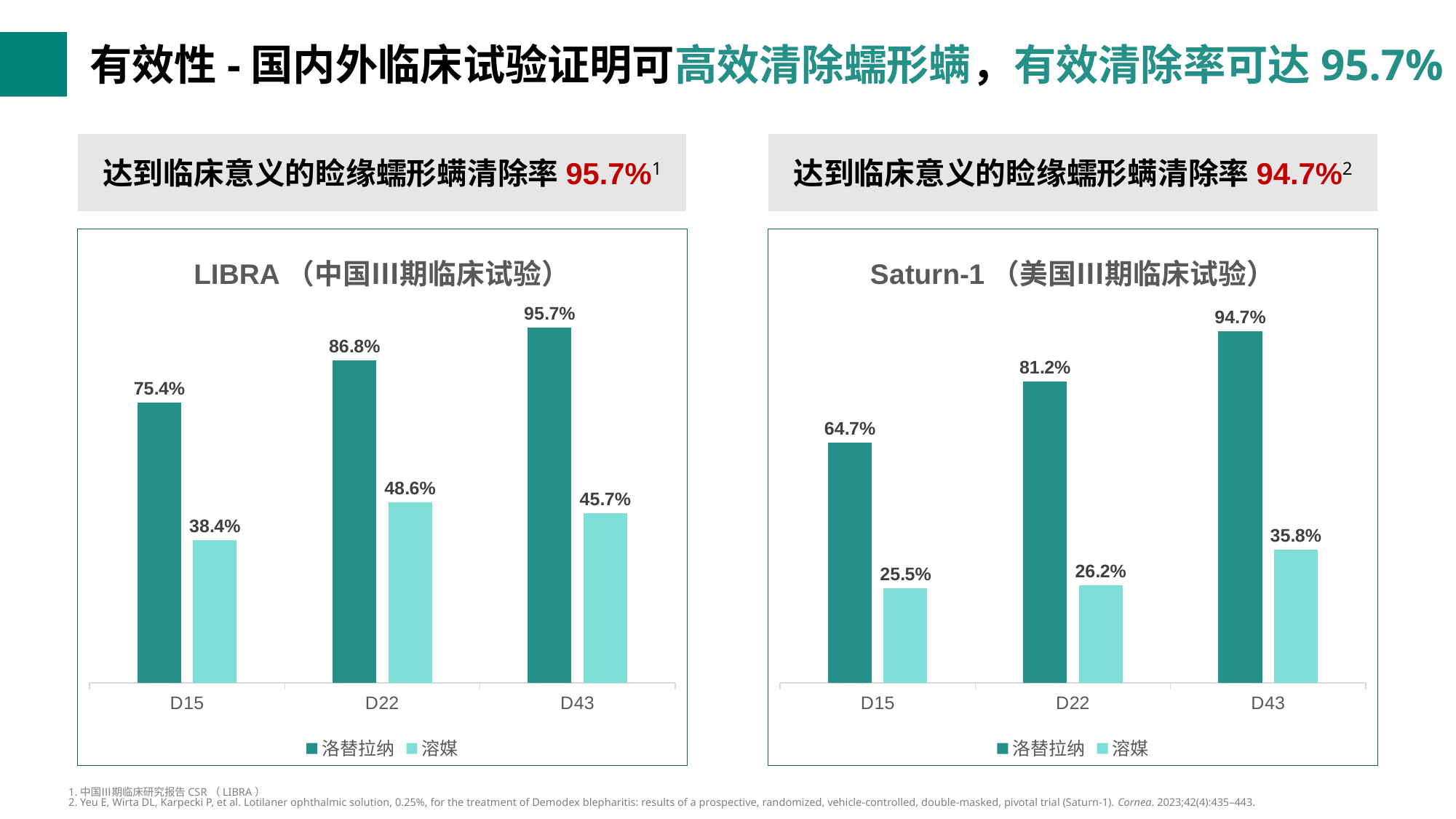
In the LIBRA (中国III期临床试验) chart, what is the value for 洛替拉纳 at D43? 95.7% In the Saturn-1 (美国III期临床试验) chart, what is the difference between 洛替拉纳 and 溶媒 at D43? 58.9% In the LIBRA (中国III期临床试验) chart, at which time point is the 溶媒 value lowest? D15 How many time points are shown on the x axis of the Saturn-1 (美国III期临床试验) chart? 3 In the LIBRA (中国III期临床试验) chart, what is the difference between the 洛替拉纳 values at D43 and D15? 20.3% What type of chart is the Saturn-1 (美国III期临床试验) chart? Bar chart In the LIBRA (中国III期临床试验) chart, which is larger for 溶媒: the value at D22 or at D43? D22 How many series does the legend of the LIBRA (中国III期临床试验) chart list? 2 In the Saturn-1 (美国III期临床试验) chart, do the 洛替拉纳 values rise or fall from D15 to D43? Rise In the Saturn-1 (美国III期临床试验) chart, at which time point is the 洛替拉纳 value highest? D43 In the Saturn-1 (美国III期临床试验) chart, what is the value for 溶媒 at D15? 25.5% In the LIBRA (中国III期临床试验) chart, what is the value for 溶媒 at D22? 48.6%